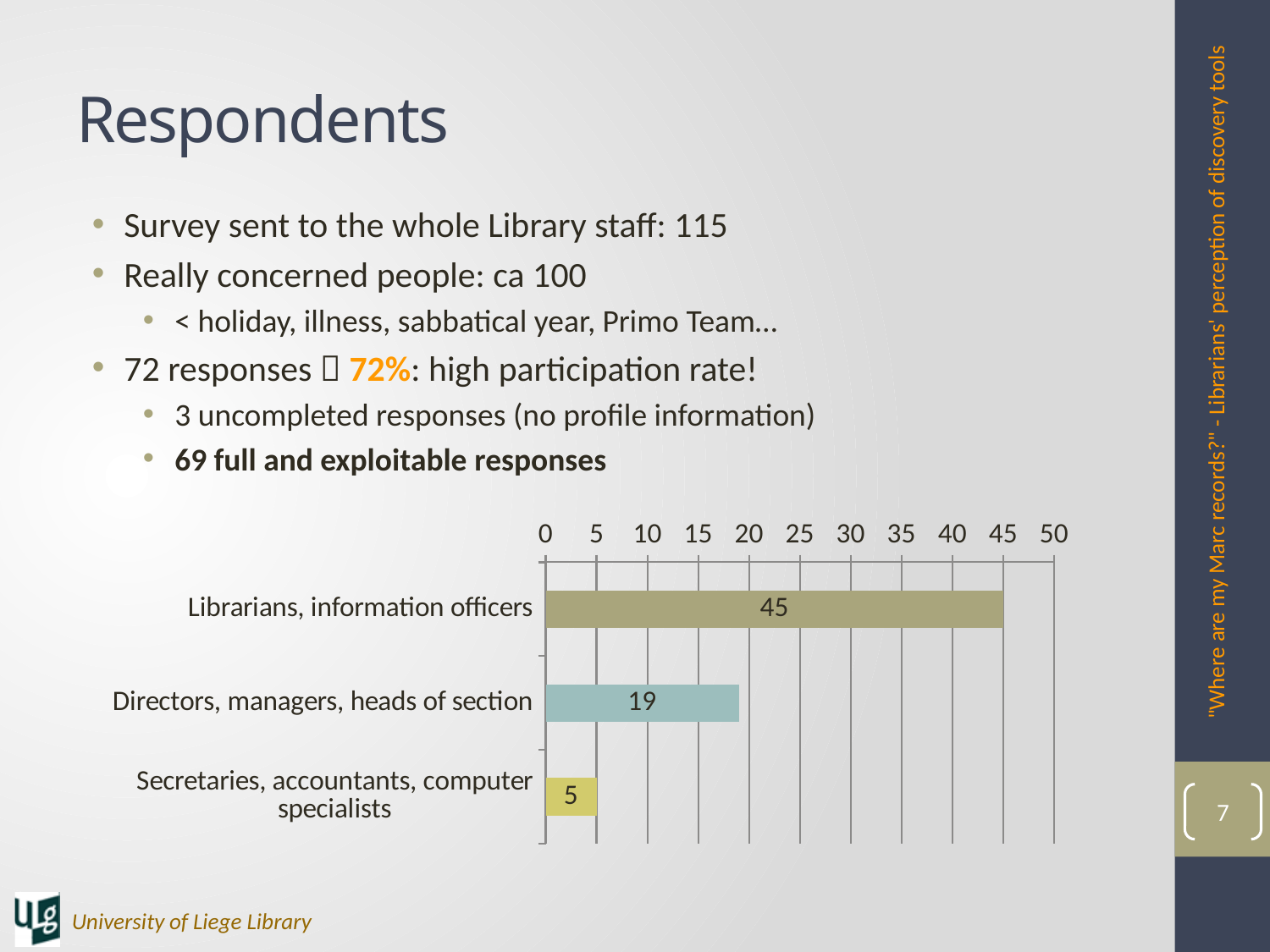
How many categories are shown in the chart? 3 What is the total of the three values shown in the chart? 69 What is the value for Secretaries, accountants, computer specialists? 5 Which category has the highest value? Librarians, information officers Which category has the lowest value? Secretaries, accountants, computer specialists Which is larger: the value for Directors, managers, heads of section or the value for Secretaries, accountants, computer specialists? Directors, managers, heads of section Is the value for Librarians, information officers greater or less than 40? greater What is the value for Librarians, information officers? 45 What kind of chart is shown on the slide? bar chart What is the difference between the values for Librarians, information officers and Directors, managers, heads of section? 26 What is the value for Directors, managers, heads of section? 19 What is the difference between the values for Directors, managers, heads of section and Secretaries, accountants, computer specialists? 14